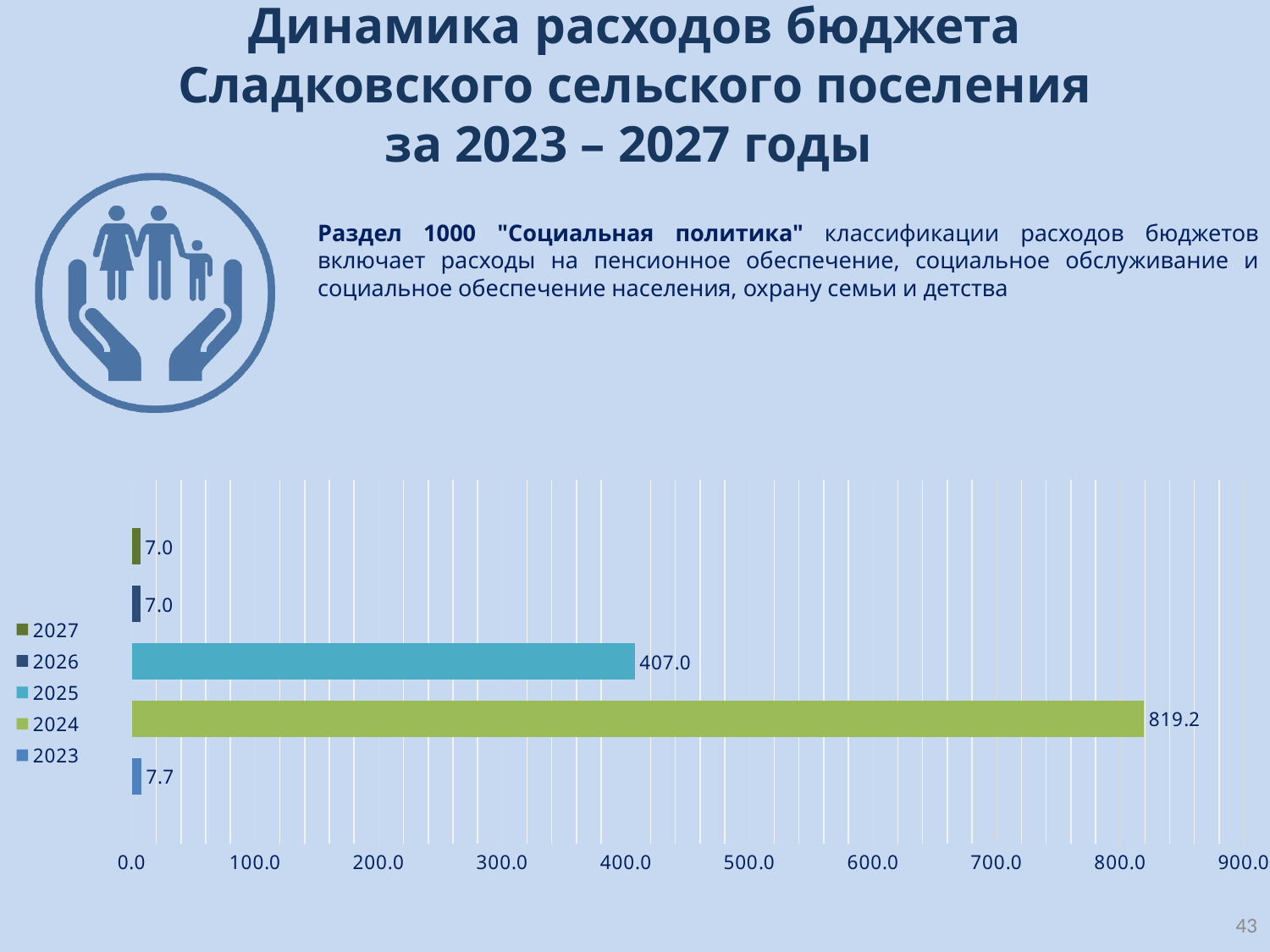
Which is larger, the value for 2025 or the value for 2024? 2024 What is the difference between the values for 2024 and 2025? 412.2 What kind of chart is shown on the slide? bar chart Which year has the highest value? 2024 What is the highest value shown on the horizontal axis? 900.0 What is the value for 2025? 407.0 What is the value for 2023? 7.7 What is the value for 2026? 7.0 Is the value for 2025 greater or less than 300.0? greater How many bars are plotted in the chart? 5 How many entries does the legend list? 5 What is the value for 2024? 819.2